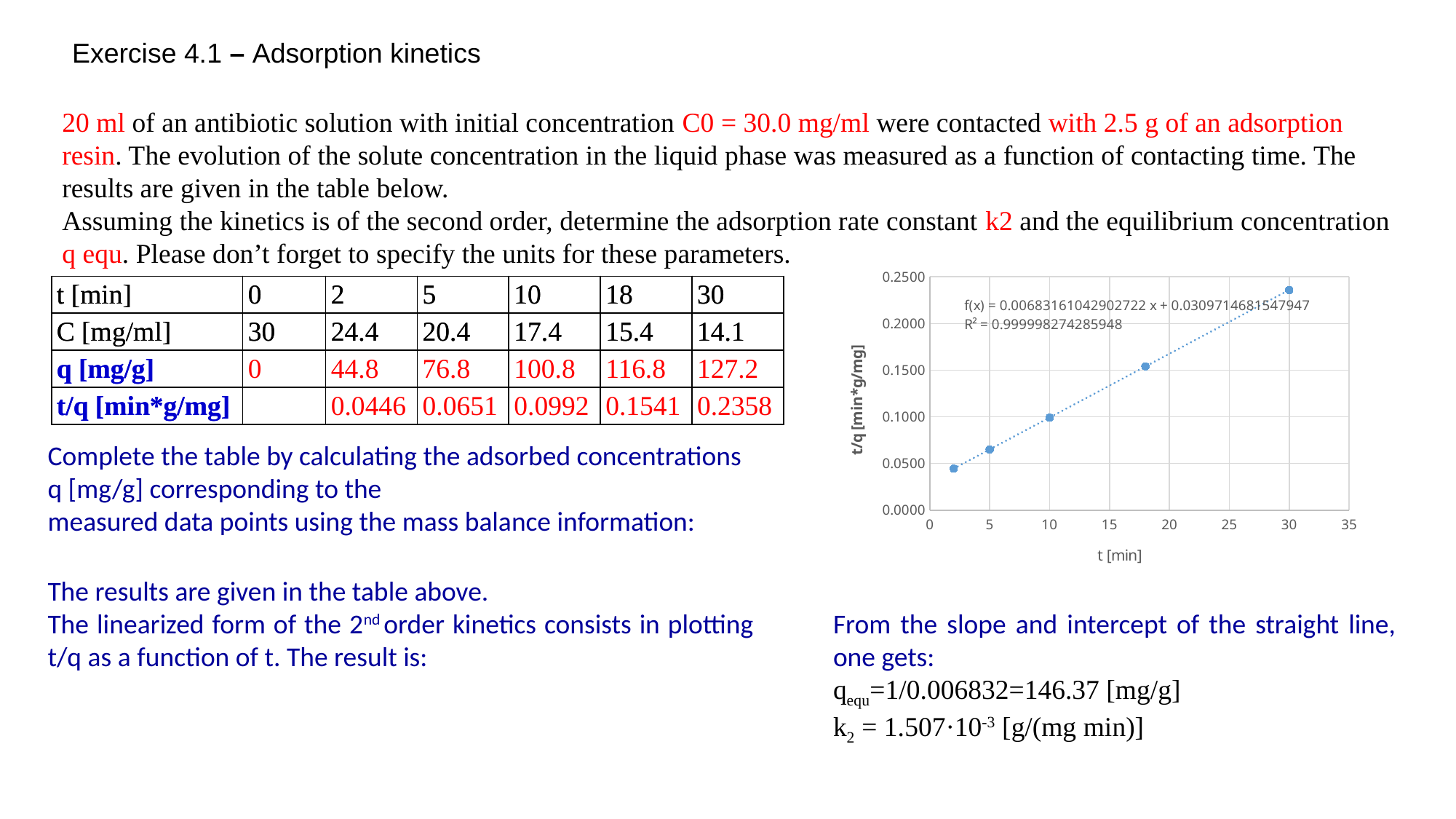
What is the t/q value plotted at t = 18 min? 0.1541 What is the label of the y axis of the chart? t/q [min*g/mg] How many data points are plotted in the chart? 5 What is the difference between the t/q values at t = 30 min and t = 2 min? 0.1912 At which t value is the plotted t/q highest? 30 Is the t/q value at t = 10 min greater or less than 0.1500? less What R² value is displayed on the chart? R² = 0.999998274285948 What kind of chart is shown on the slide? scatter chart Is the t/q value at t = 30 min greater or less than 0.2000? greater At which t value is the plotted t/q lowest? 2 Do the plotted t/q values rise or fall as t increases? rise